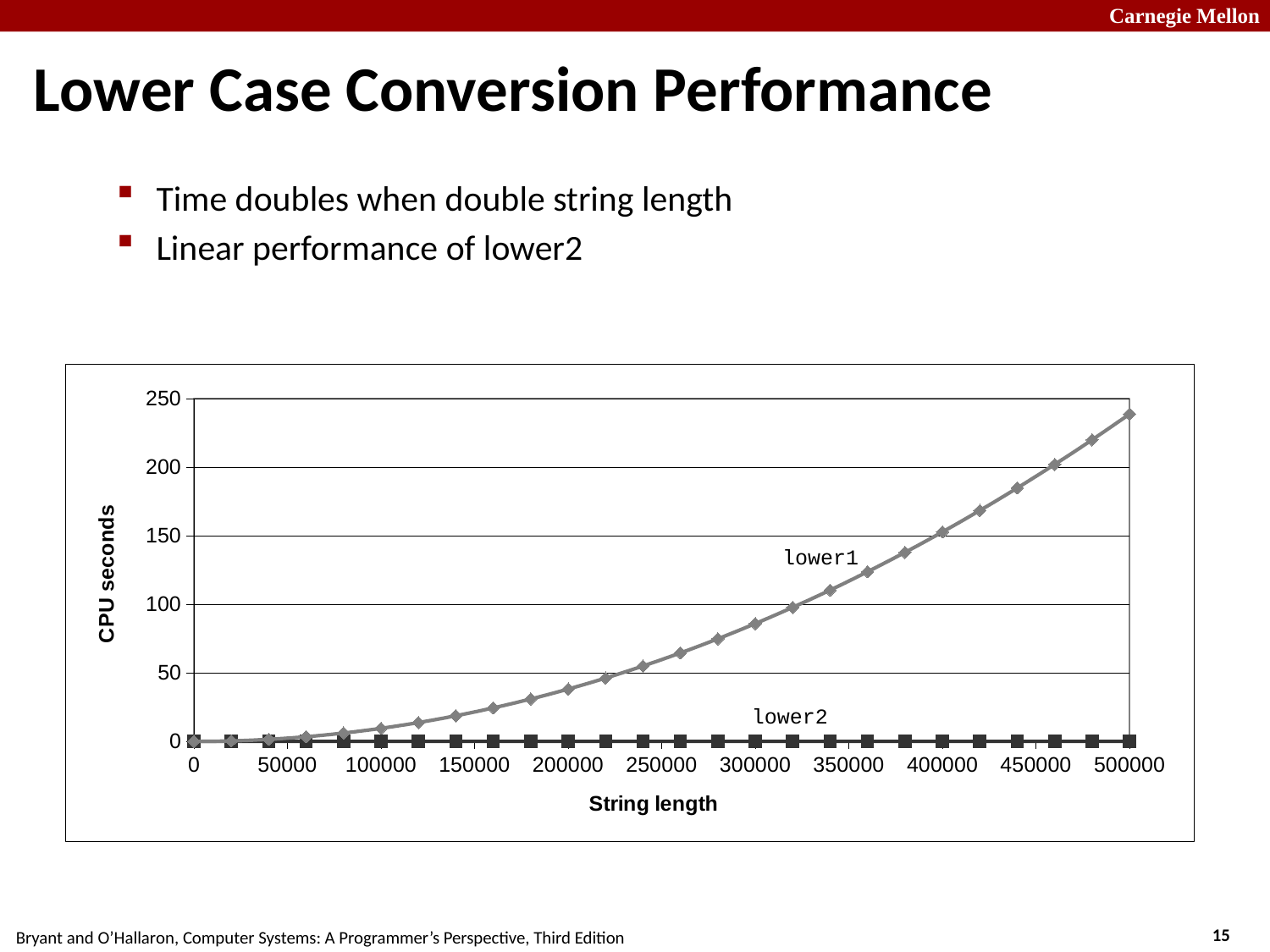
Is the value for lower1 at string length 500000 greater or less than 200? greater Which series reaches the highest CPU seconds on the chart? lower1 Is the value for lower1 at string length 400000 greater or less than 100? greater How many data series are plotted on the chart? 2 What is the label of the x axis of the chart? String length Is the value for lower1 at string length 300000 greater or less than 100? less At string length 500000, which series has the larger CPU seconds value, lower1 or lower2? lower1 What is the label of the y axis of the chart? CPU seconds How many labeled tick marks are on the x axis of the chart? 11 What kind of chart is shown on the slide? line chart Does the CPU seconds value for lower1 rise or fall as string length increases? rise